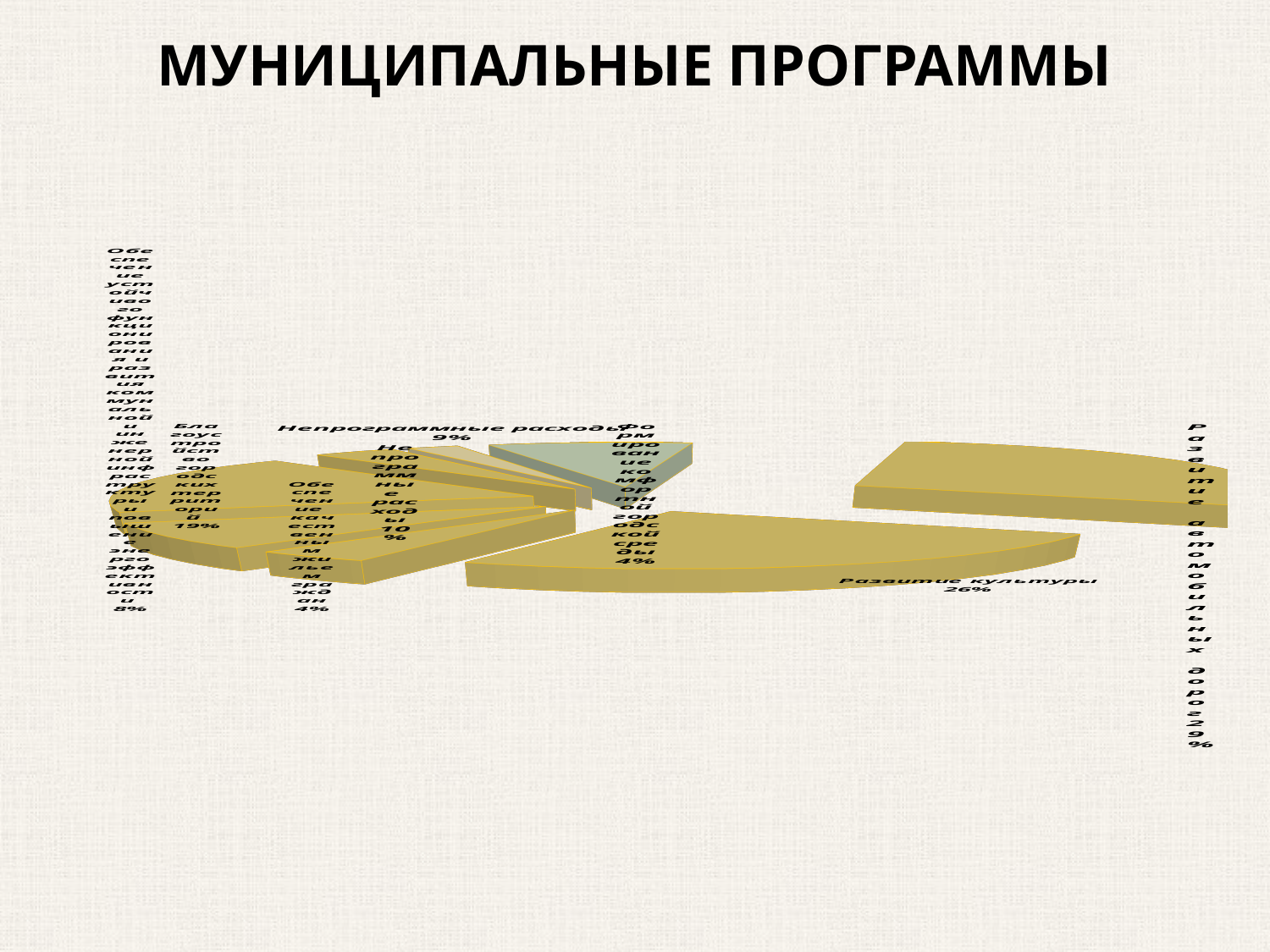
What is the title of the slide containing the chart? МУНИЦИПАЛЬНЫЕ ПРОГРАММЫ Which is larger: Развитие культуры or Развитие автомобильных дорог? Развитие автомобильных дорог What share of the pie does Развитие культуры have? 26% What is the difference in percentage points between Развитие культуры and Благоустройство городской территории? 7 percentage points What is the combined share of Развитие культуры and Развитие автомобильных дорог? 55% Which is larger: Развитие культуры or Благоустройство городской территории? Развитие культуры Which slice of the pie is the largest? Развитие автомобильных дорог What share of the pie does Развитие автомобильных дорог have? 29% What is the difference in percentage points between Развитие автомобильных дорог and Развитие культуры? 3 percentage points What kind of chart is shown on the slide? pie chart What share of the pie does Благоустройство городской территории have? 19%